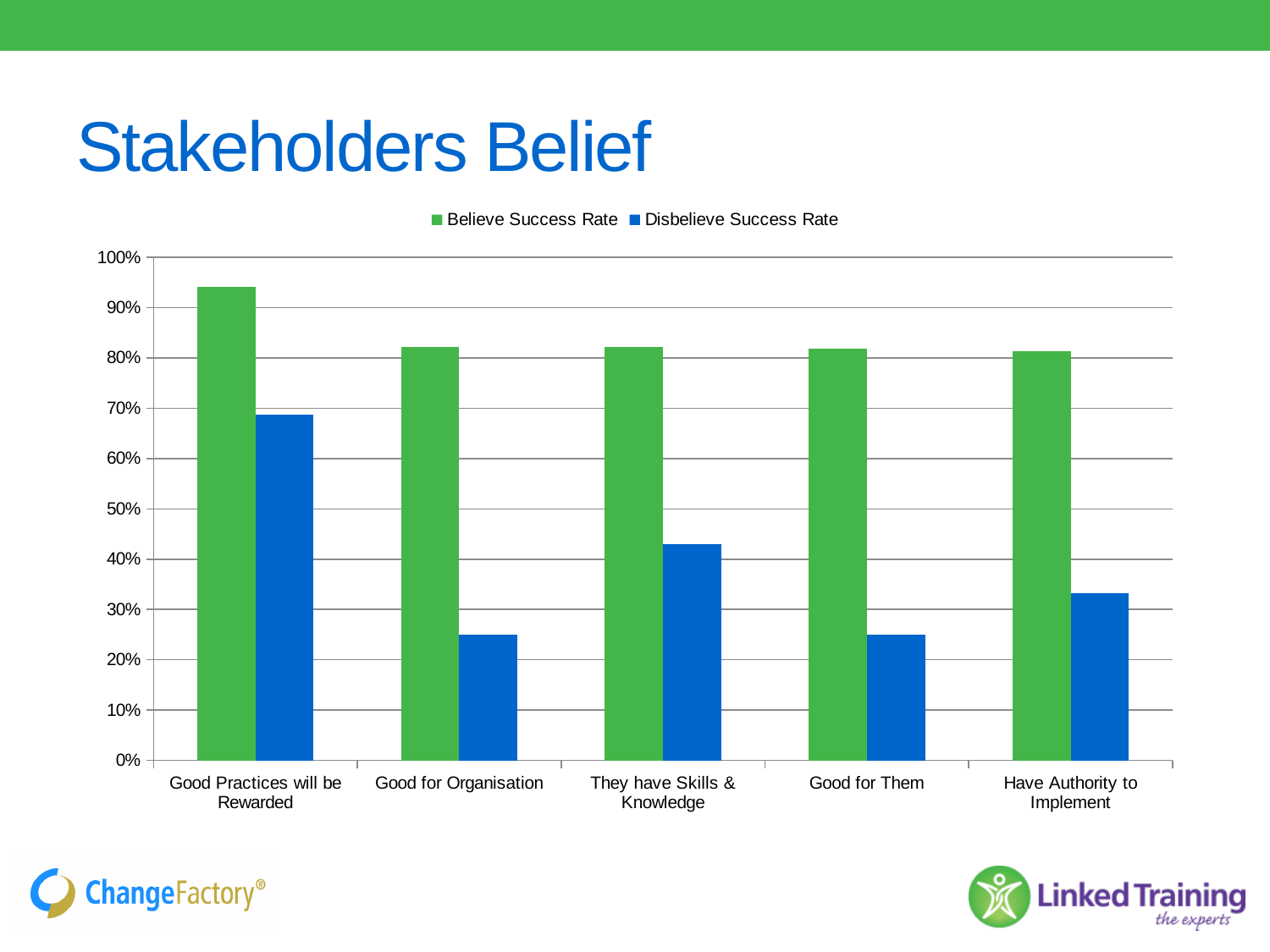
Is the Believe Success Rate for Good Practices will be Rewarded greater or less than 90%? greater How many categories are shown on the x axis? 5 Which category has the highest Believe Success Rate? Good Practices will be Rewarded Which colour represents the Disbelieve Success Rate series? blue Which is larger for Have Authority to Implement: the Believe Success Rate or the Disbelieve Success Rate? Believe Success Rate What kind of chart is shown on the slide? bar chart Is the Disbelieve Success Rate for They have Skills & Knowledge greater or less than 40%? greater Which is larger: the Disbelieve Success Rate for They have Skills & Knowledge or for Good for Them? They have Skills & Knowledge Which category has the highest Disbelieve Success Rate? Good Practices will be Rewarded How many series does the legend list? 2 Is the Disbelieve Success Rate for Good for Organisation greater or less than 30%? less